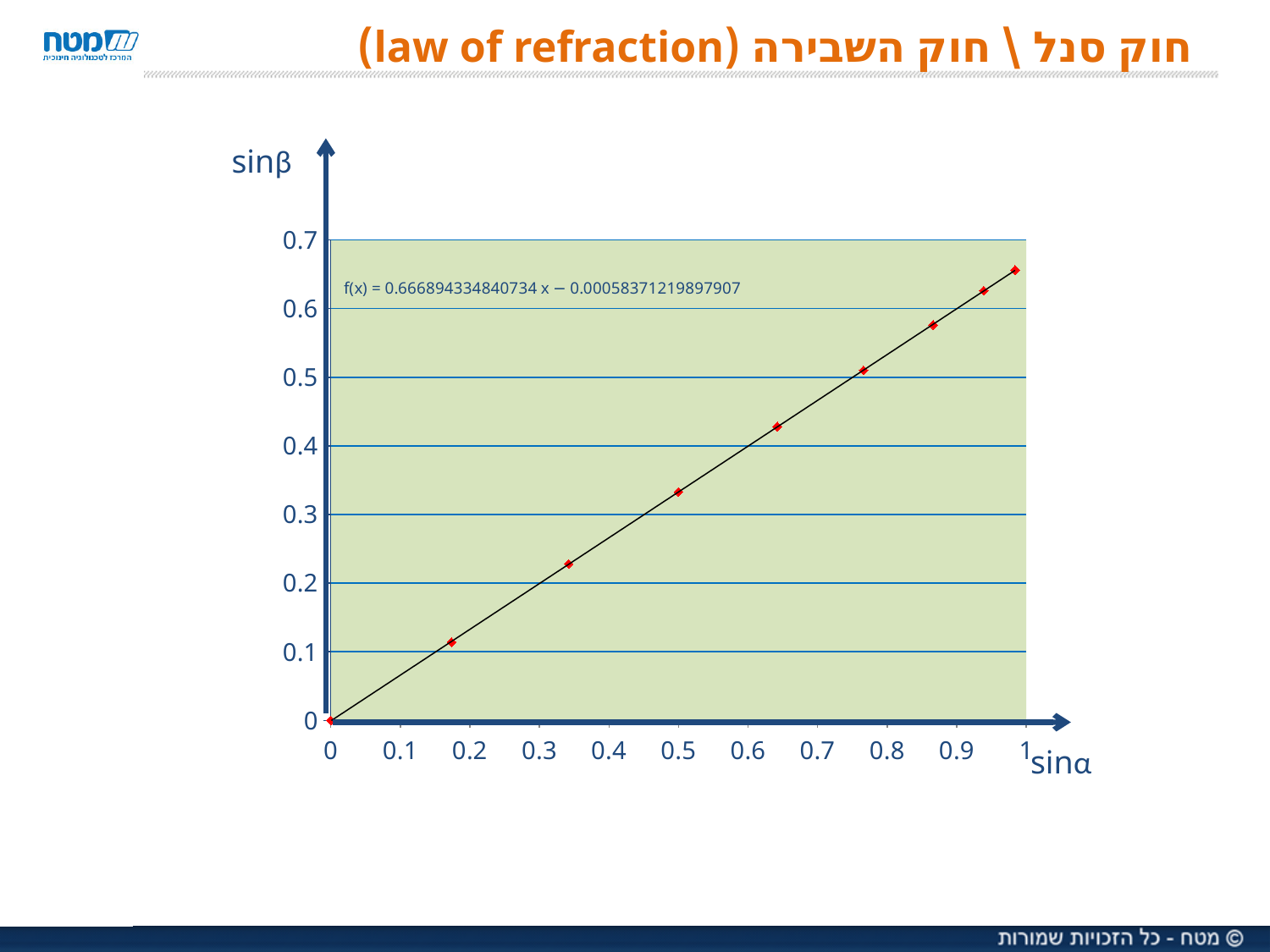
What kind of chart is shown on the slide? scatter chart Which data point has the highest sinβ value: the one at sinα ≈ 0.5 or the one at sinα ≈ 0.87? the one at sinα ≈ 0.87 Is the sinβ value of the rightmost data point greater or less than 0.6? greater How many data points are plotted on the chart? 9 Is the sinβ value of the data point at sinα ≈ 0.34 greater or less than 0.2? greater Do the values of sinβ rise or fall as sinα increases along the x axis? rise What is the slope of the fitted line according to the equation printed on the chart? 0.666894334840734 Is the sinβ value of the data point at sinα ≈ 0.5 greater or less than 0.4? less What is the label of the vertical axis? sinβ